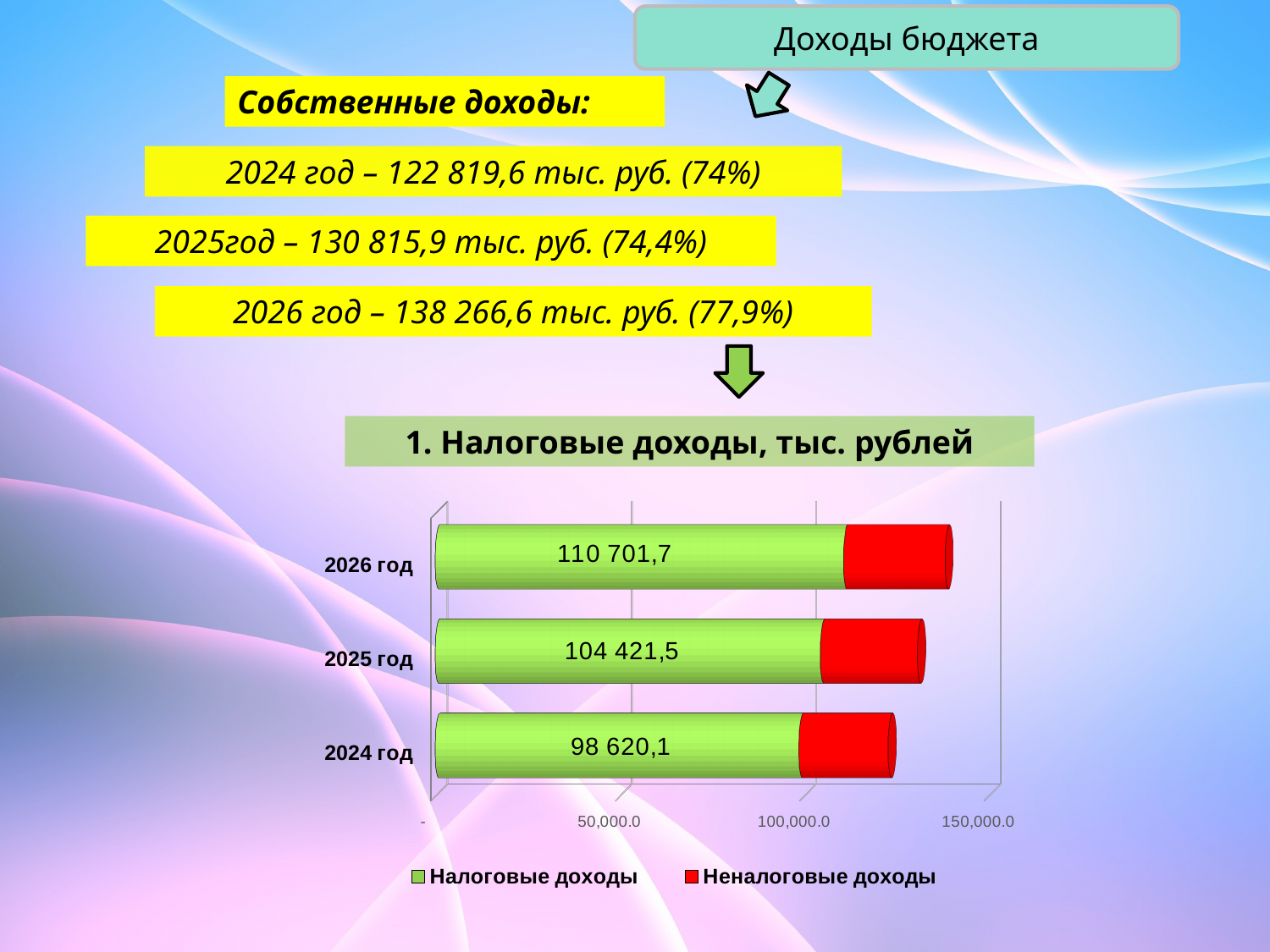
Which year has the highest value of Налоговые доходы? 2026 год What is the difference in Налоговые доходы between 2026 год and 2024 год? 12 081,6 What kind of chart is shown on the slide? bar chart Which year has the lowest value of Налоговые доходы? 2024 год Do the values of Налоговые доходы rise or fall from 2024 год to 2026 год? rise What is the value of Налоговые доходы for 2024 год? 98 620,1 Is the total length of the stacked bar for 2024 год greater or less than 100,000.0? greater How many series does the legend list? 2 What is the value of Налоговые доходы for 2026 год? 110 701,7 How many years are shown in the chart? 3 Which is larger, Налоговые доходы for 2025 год or for 2026 год? 2026 год What is the value of Налоговые доходы for 2025 год? 104 421,5